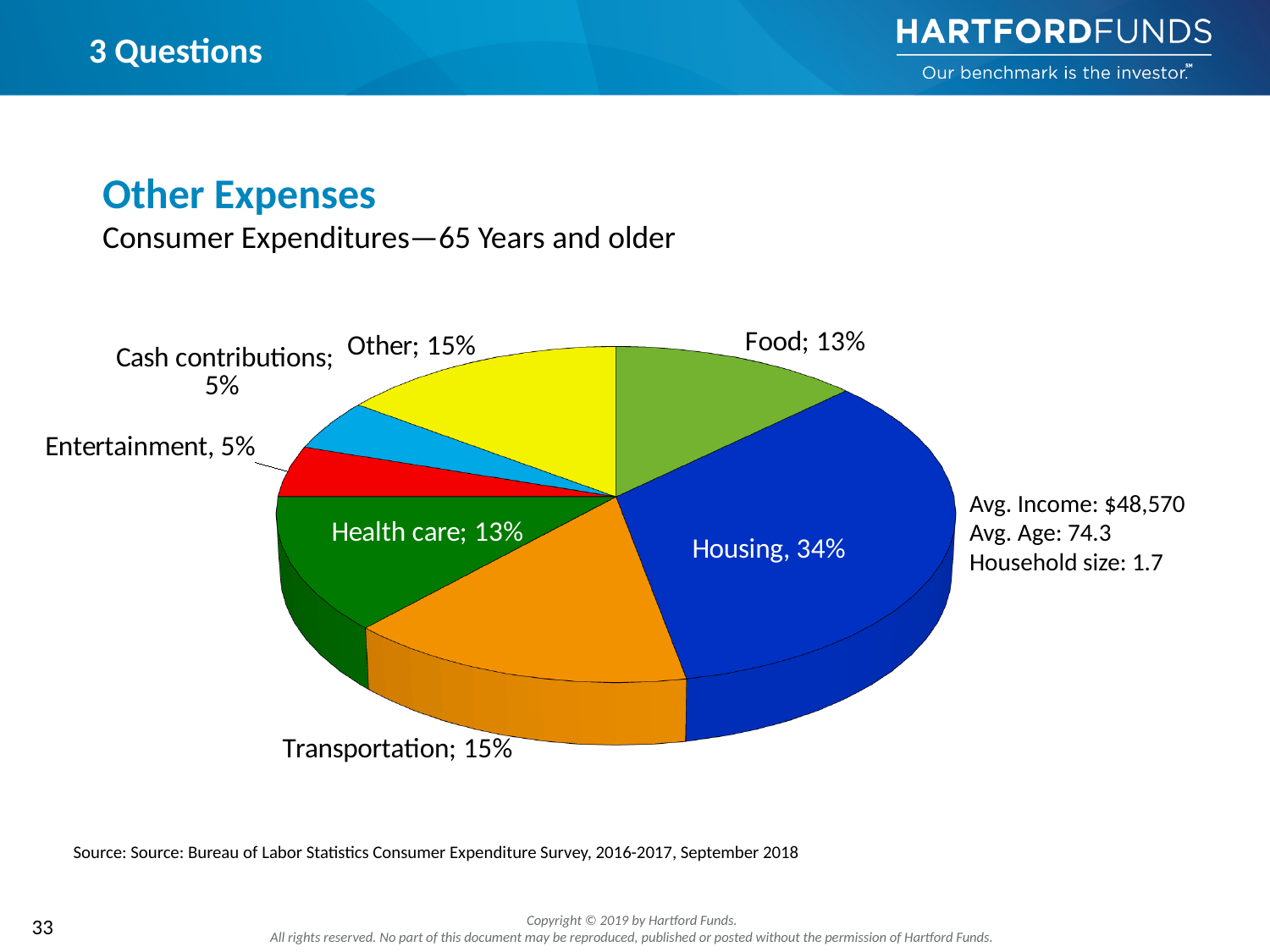
What is the combined share of Entertainment and Cash contributions? 10% What is the difference in percentage points between Housing and Food? 21 What is the subtitle of the chart below 'Other Expenses'? Consumer Expenditures—65 Years and older How many categories are shown in the pie chart? 7 What colour is the Housing slice of the pie? Blue Which category has the largest share of the pie? Housing Which is larger, the share for Transportation or the share for Health care? Transportation What percentage is shown for Cash contributions? 5% What percentage of the pie is Health care? 13% What type of chart is shown on the slide? Pie chart What share of consumer expenditures for those 65 years and older goes to Housing? 34% What share does Transportation represent in the pie chart? 15%